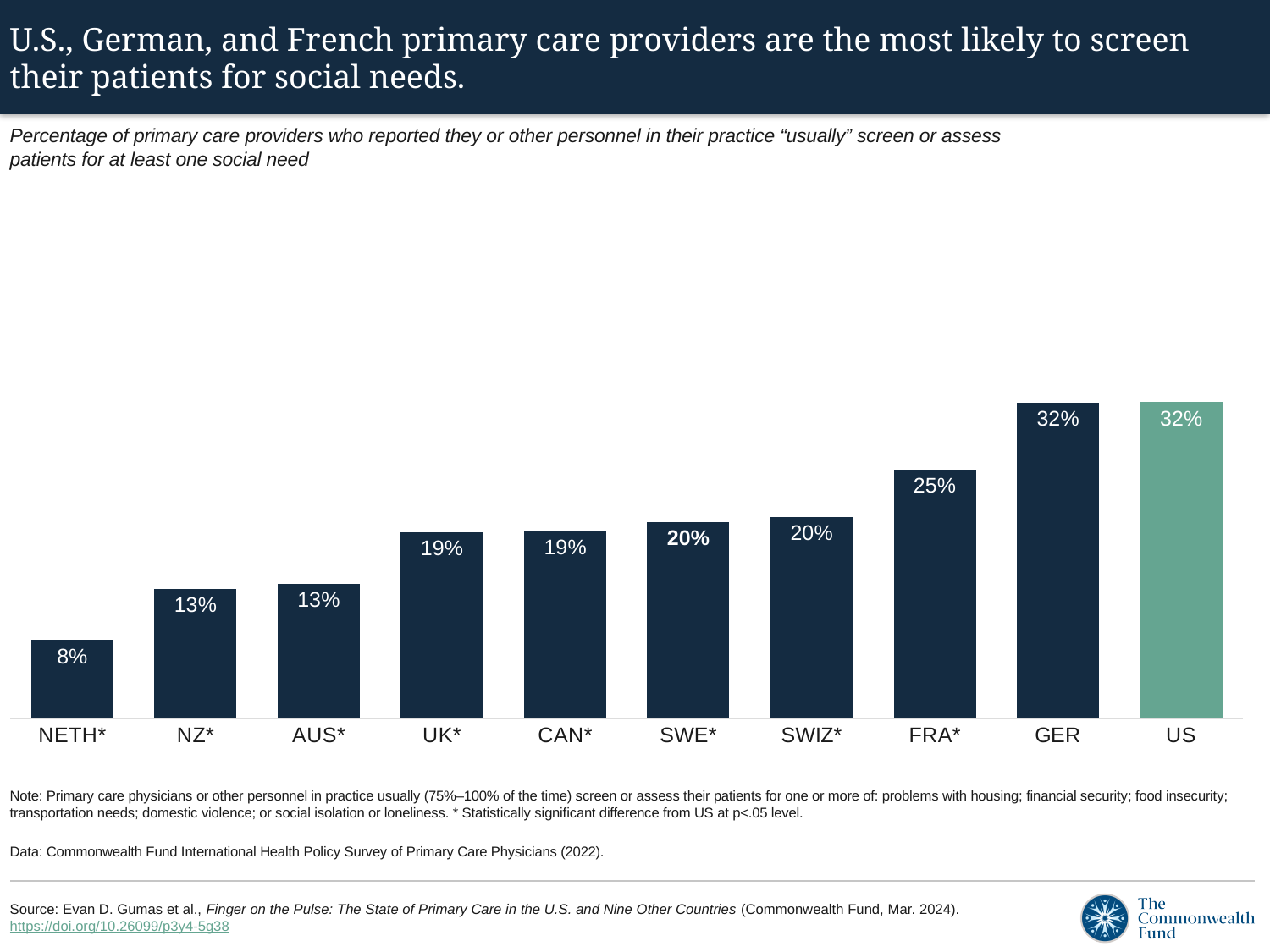
Do the values rise or fall from left to right along the x axis? Rise Which is larger, the value for NZ* or the value for CAN*? CAN* Which is larger, the value for FRA* or the value for SWIZ*? FRA* What kind of chart is shown on the slide? Bar chart What is the difference between the values for GER and FRA*? 7% What is the value for US? 32% Which category has the lowest value? NETH* What is the value for SWE*? 20% How many categories are shown on the x axis? 10 What is the value for NETH*? 8% What is the difference between the values for UK* and NETH*? 11% What is the value for FRA*? 25%